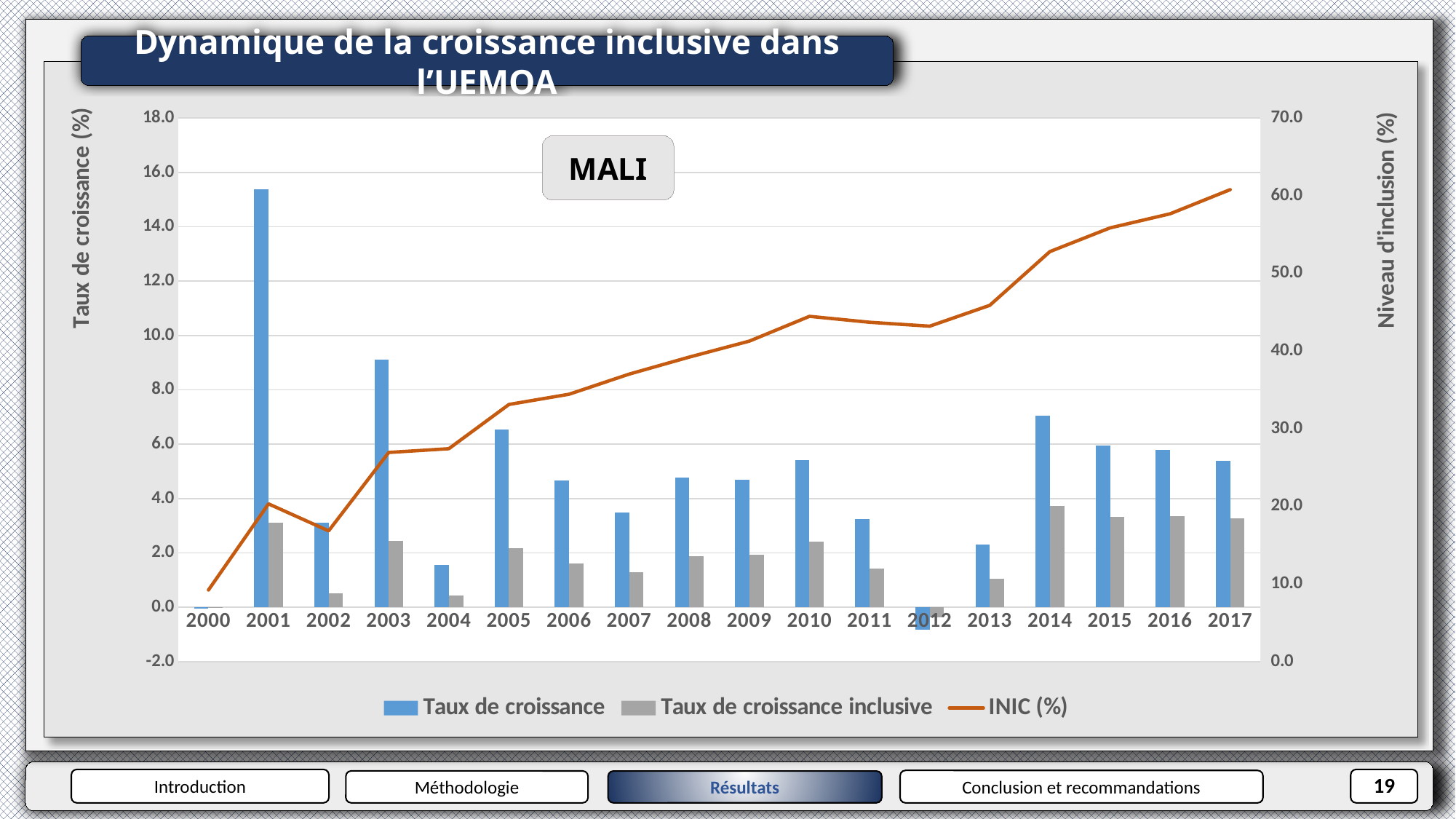
Is the Taux de croissance value for 2001 greater or less than 14.0? greater Is the INIC (%) value for 2014 greater or less than 50.0? greater Which year has the larger Taux de croissance bar, 2003 or 2005? 2003 How many series does the legend list? 3 How many years are shown on the x axis? 18 Does the INIC (%) line generally rise or fall from 2000 to 2017? Rise In which year is the Taux de croissance bar the lowest? 2012 What is the title of the right-hand vertical axis? Niveau d'inclusion (%) In which year is the Taux de croissance bar the highest? 2001 In which year is the Taux de croissance inclusive bar the highest? 2014 What kind of chart is shown on the slide? A bar chart combined with a line series Is the Taux de croissance value for 2004 greater or less than 2.0? less